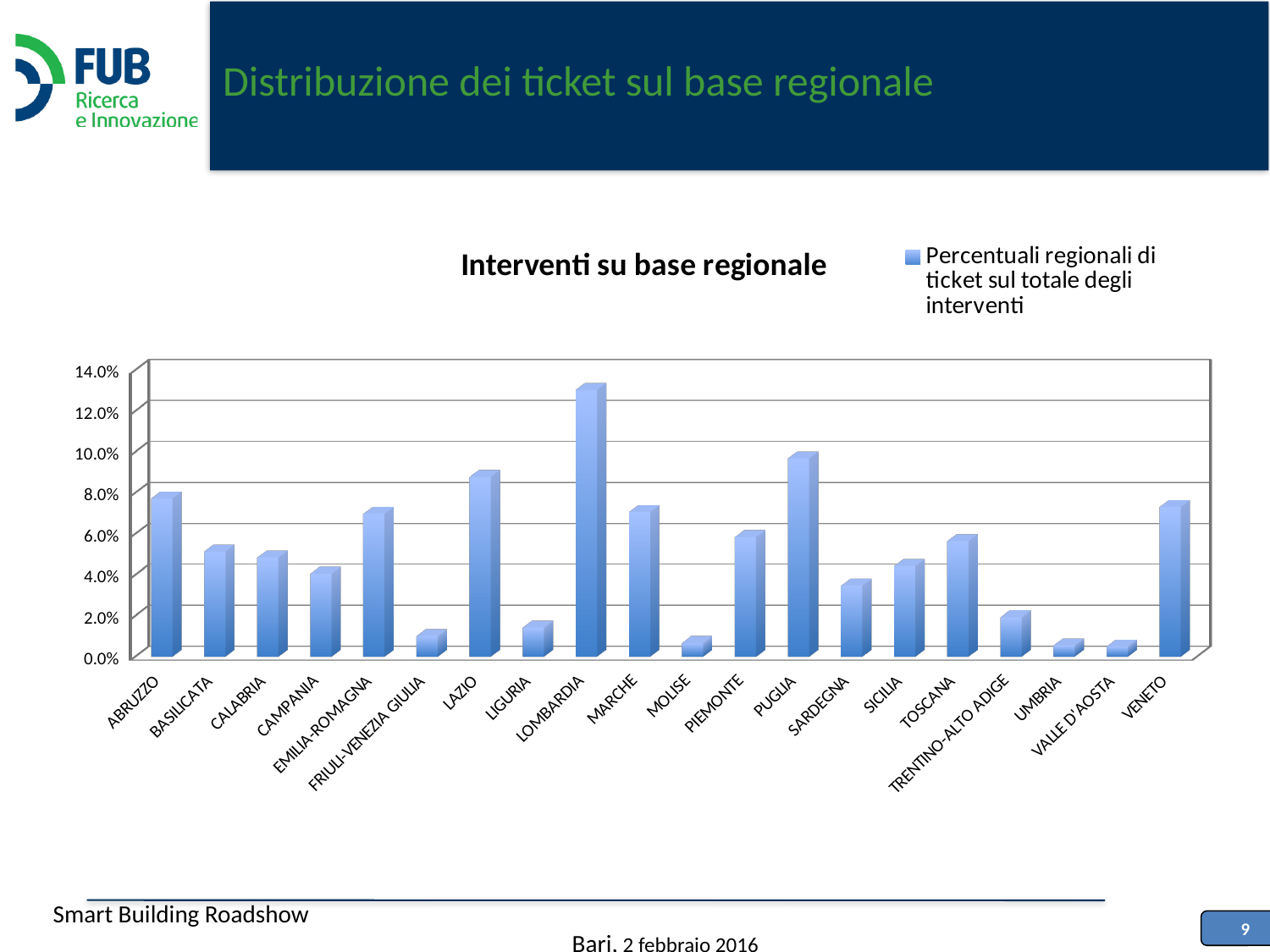
Is the value for FRIULI-VENEZIA GIULIA greater or less than 2.0%? less Which region has the highest percentage of tickets? LOMBARDIA Is the value for EMILIA-ROMAGNA greater or less than 6.0%? greater What kind of chart is shown on the slide? bar chart Which has a larger value, VENETO or SARDEGNA? VENETO Is the value for LOMBARDIA greater or less than 12.0%? greater What is the title of the chart? Interventi su base regionale How many regions are shown on the x axis of the chart? 20 How many series does the legend list? 1 Which has a larger value, LOMBARDIA or PUGLIA? LOMBARDIA